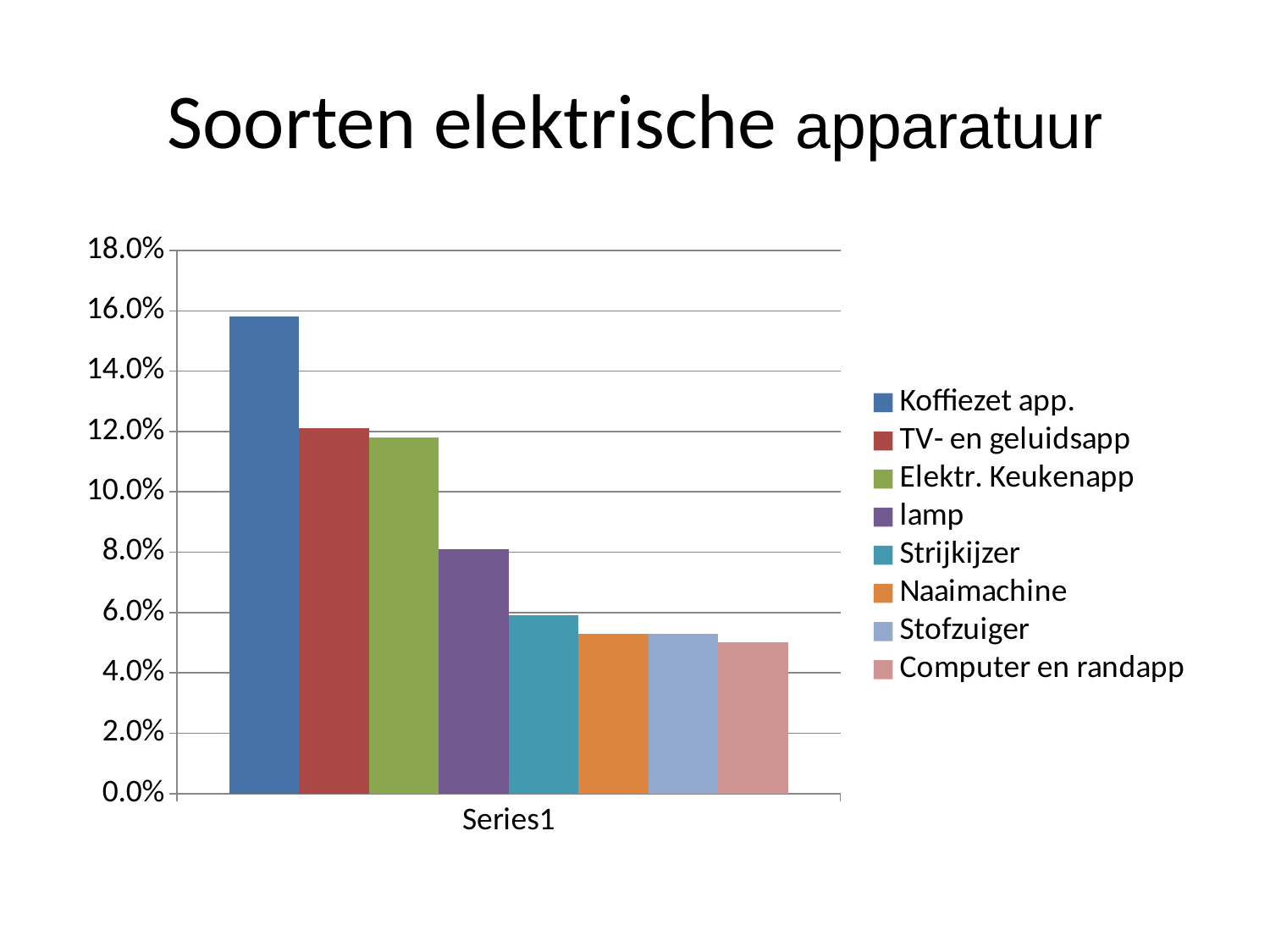
Which is larger, the value for Naaimachine or the value for Koffiezet app.? Koffiezet app. How many entries does the legend list? 8 How many bars are plotted in the chart? 8 What is the title of the slide containing the chart? Soorten elektrische apparatuur Is the value for Strijkijzer greater or less than 4.0%? greater Is the value for Computer en randapp greater or less than 6.0%? less What kind of chart is shown on the slide? bar chart Is the value for Koffiezet app. greater or less than 14.0%? greater Which category has the highest value in the chart? Koffiezet app. Which is larger, the value for Elektr. Keukenapp or the value for lamp? Elektr. Keukenapp